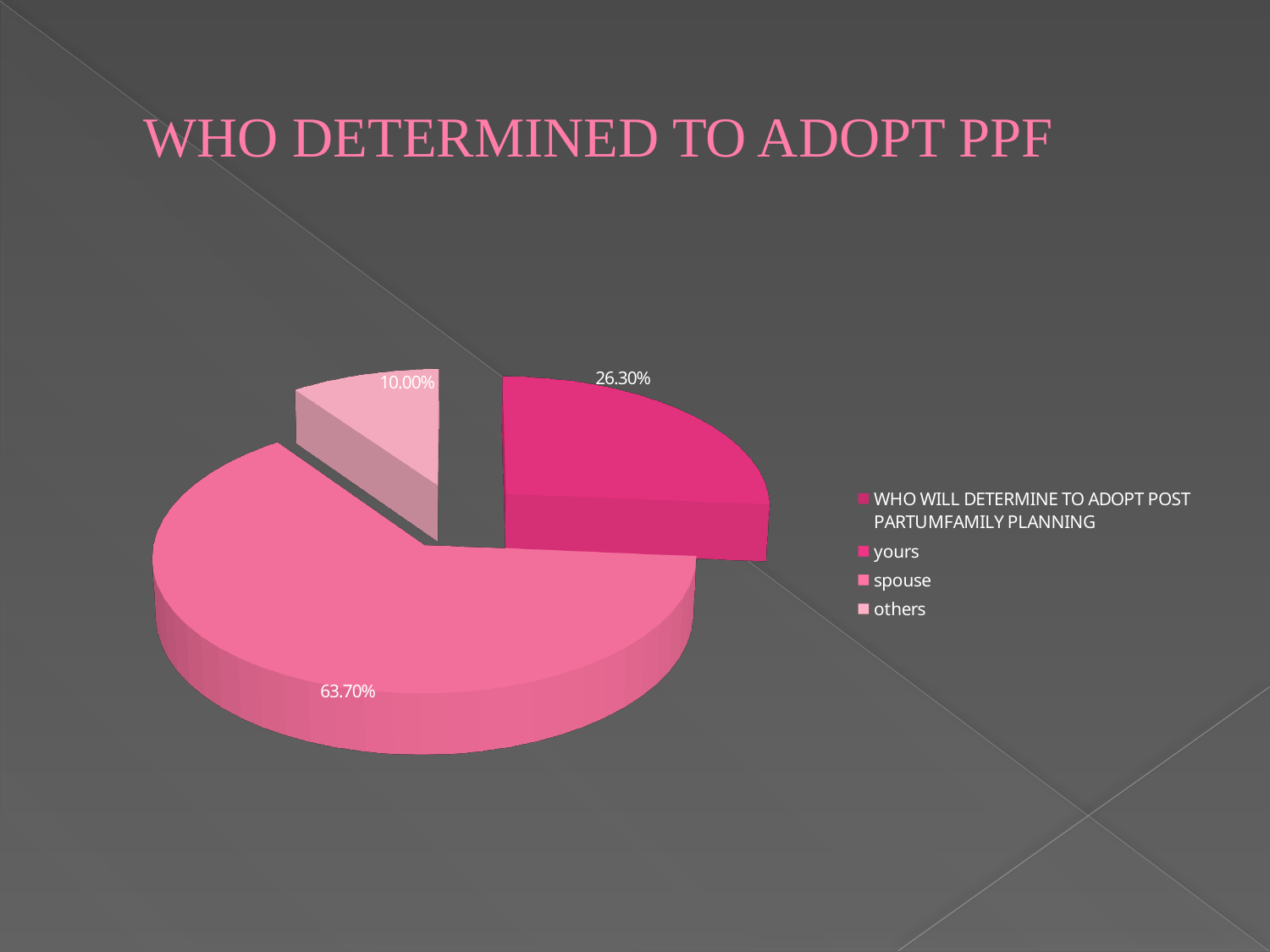
What percentage is shown for the yours slice? 26.30% Which slice of the pie is the largest? spouse What is the title of the slide's chart? WHO DETERMINED TO ADOPT PPF How many slices with data labels does the pie chart have? 3 Which slice of the pie is the smallest? others How many entries does the legend list? 4 What percentage of the pie is labelled for the spouse slice? 63.70% What is the difference between the spouse slice and the yours slice? 37.40% What is the difference between the largest slice (63.70%) and the smallest slice (10.00%)? 53.70% What percentage is shown for the others slice? 10.00% What type of chart is shown on the slide? pie chart Which is larger, the yours slice or the others slice? yours